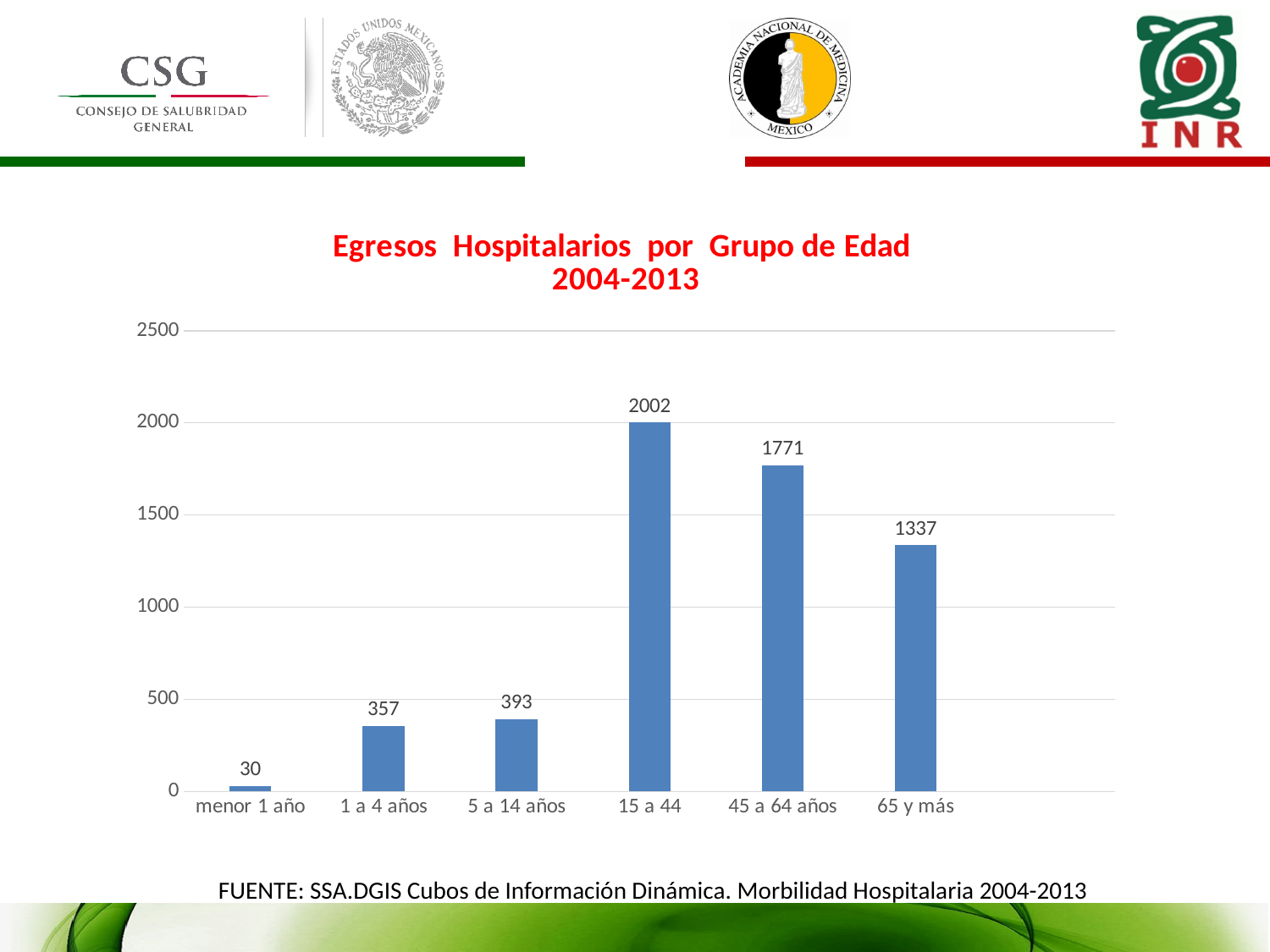
What kind of chart is shown on the slide? bar chart What is the value for the '15 a 44' age group? 2002 How many age groups are shown on the chart? 6 Is the value for '5 a 14 años' greater or less than 500? less Which age group has the highest number of hospital discharges? 15 a 44 What is the difference between the values for '15 a 44' and '45 a 64 años'? 231 What is the value for the 'menor 1 año' age group? 30 What is the difference between the values for '5 a 14 años' and '1 a 4 años'? 36 What is the title of the chart? Egresos Hospitalarios por Grupo de Edad 2004-2013 Which age group has the lowest number of hospital discharges? menor 1 año Which is larger, the value for '45 a 64 años' or for '65 y más'? 45 a 64 años What is the value for the '65 y más' age group? 1337